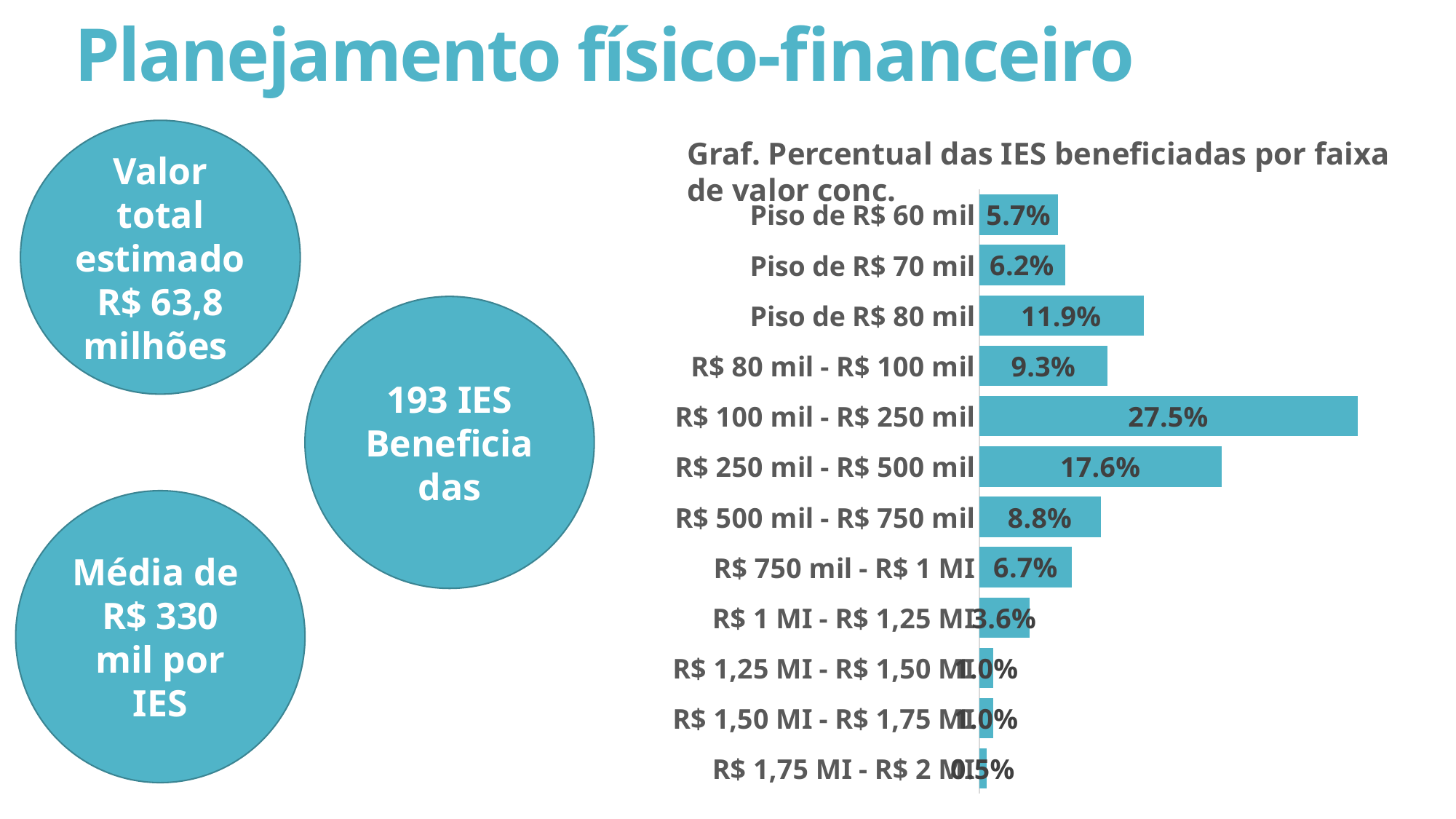
What is the value for 'R$ 750 mil - R$ 1 MI'? 6.7% Which value range has the highest percentage of IES? R$ 100 mil - R$ 250 mil What is the difference between the values for 'R$ 100 mil - R$ 250 mil' and 'R$ 250 mil - R$ 500 mil'? 9.9% Which is larger, the value for 'Piso de R$ 70 mil' or 'R$ 500 mil - R$ 750 mil'? R$ 500 mil - R$ 750 mil How many value ranges (categories) are shown in the chart? 12 What is the difference between the values for 'Piso de R$ 80 mil' and 'R$ 80 mil - R$ 100 mil'? 2.6% What type of chart is shown on the slide? Bar chart What percentage of IES is shown for the 'R$ 100 mil - R$ 250 mil' range? 27.5% What is the title of the chart? Graf. Percentual das IES beneficiadas por faixa de valor conc. Which is larger, the value for 'Piso de R$ 60 mil' or 'R$ 1 MI - R$ 1,25 MI'? Piso de R$ 60 mil What is the value for 'R$ 250 mil - R$ 500 mil'? 17.6% What is the value for 'Piso de R$ 80 mil'? 11.9%